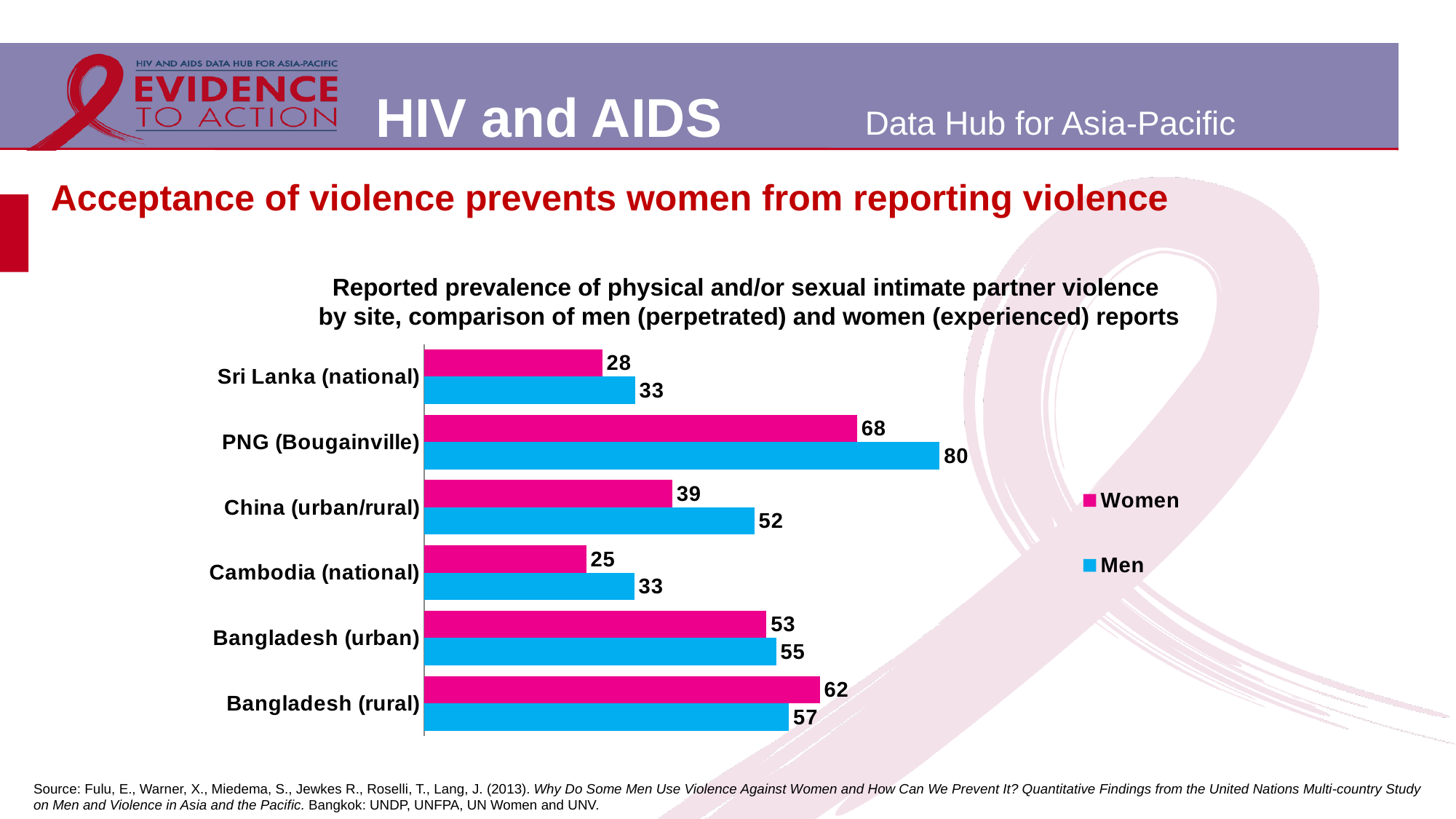
What is the difference between the Men and Women values for PNG (Bougainville)? 12 Which colour represents Men in the chart? Blue What is the Women value for Cambodia (national)? 25 What kind of chart is shown on the slide? Bar chart For Bangladesh (rural), which is larger, the Women value or the Men value? Women What is the Women value for PNG (Bougainville)? 68 How many series does the legend list? 2 What is the difference between the Men values for Sri Lanka (national) and Cambodia (national)? 0 Which site has the lowest Women value? Cambodia (national) What is the Men value for China (urban/rural)? 52 Which site has the highest Men value? PNG (Bougainville) How many sites are shown on the chart? 6